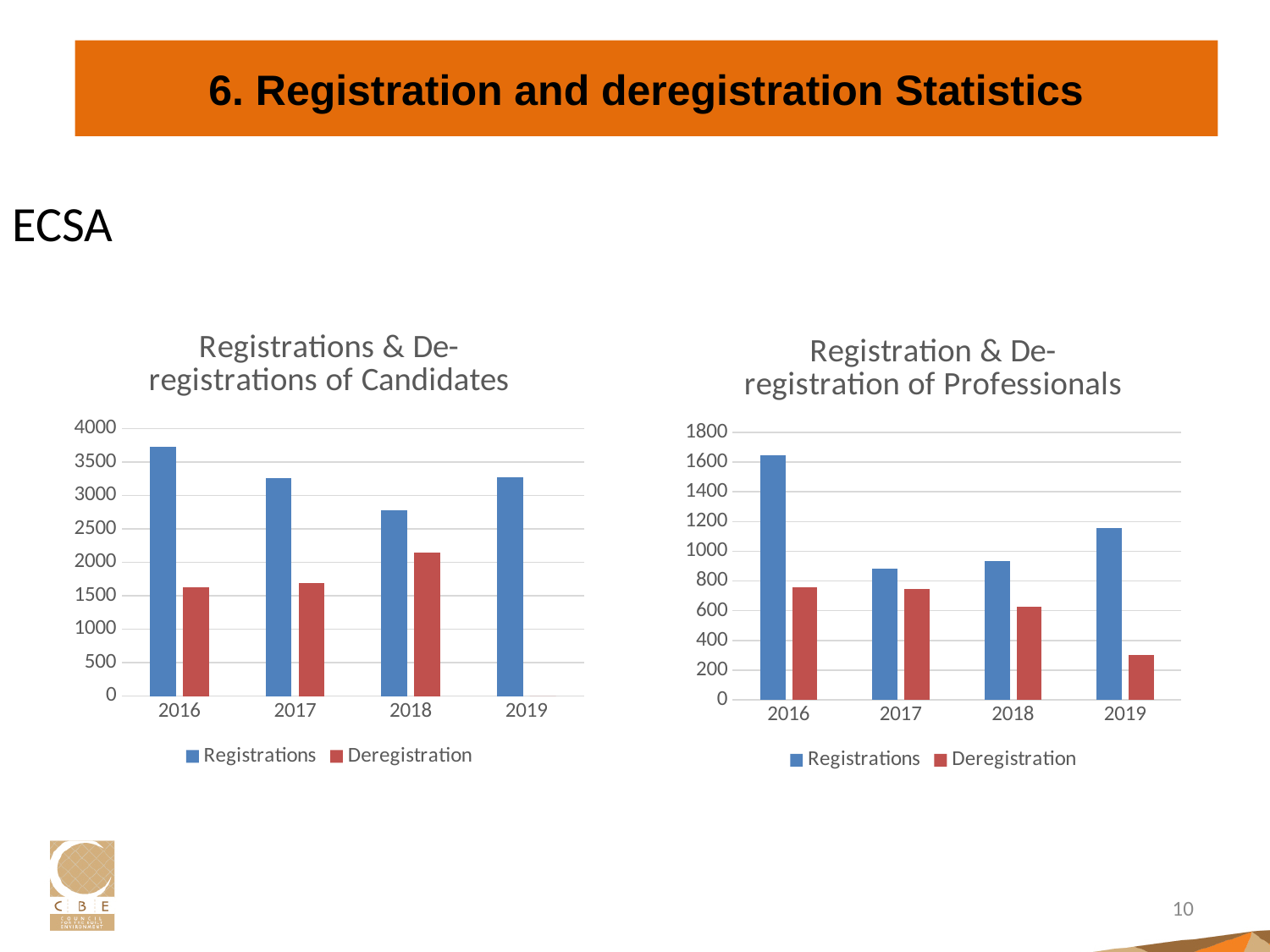
In the 'Registrations & De-registrations of Candidates' chart, is the Registrations value for 2018 greater or less than 3000? less In the 'Registrations & De-registrations of Candidates' chart, which year has the highest Deregistration value? 2018 In the 'Registration & De-registration of Professionals' chart, is the Registrations value for 2016 greater or less than 1400? greater In the 'Registration & De-registration of Professionals' chart, is the Deregistration value for 2019 greater or less than 400? less In the 'Registration & De-registration of Professionals' chart, which year has the lowest Deregistration value? 2019 In the 'Registrations & De-registrations of Candidates' chart, which year has the highest Registrations value? 2016 How many series does the legend of the 'Registrations & De-registrations of Candidates' chart list? 2 What kind of chart is the 'Registrations & De-registrations of Candidates' chart? bar chart How many years are shown on the x axis of the 'Registration & De-registration of Professionals' chart? 4 In the 'Registration & De-registration of Professionals' chart, which year has the highest Registrations value? 2016